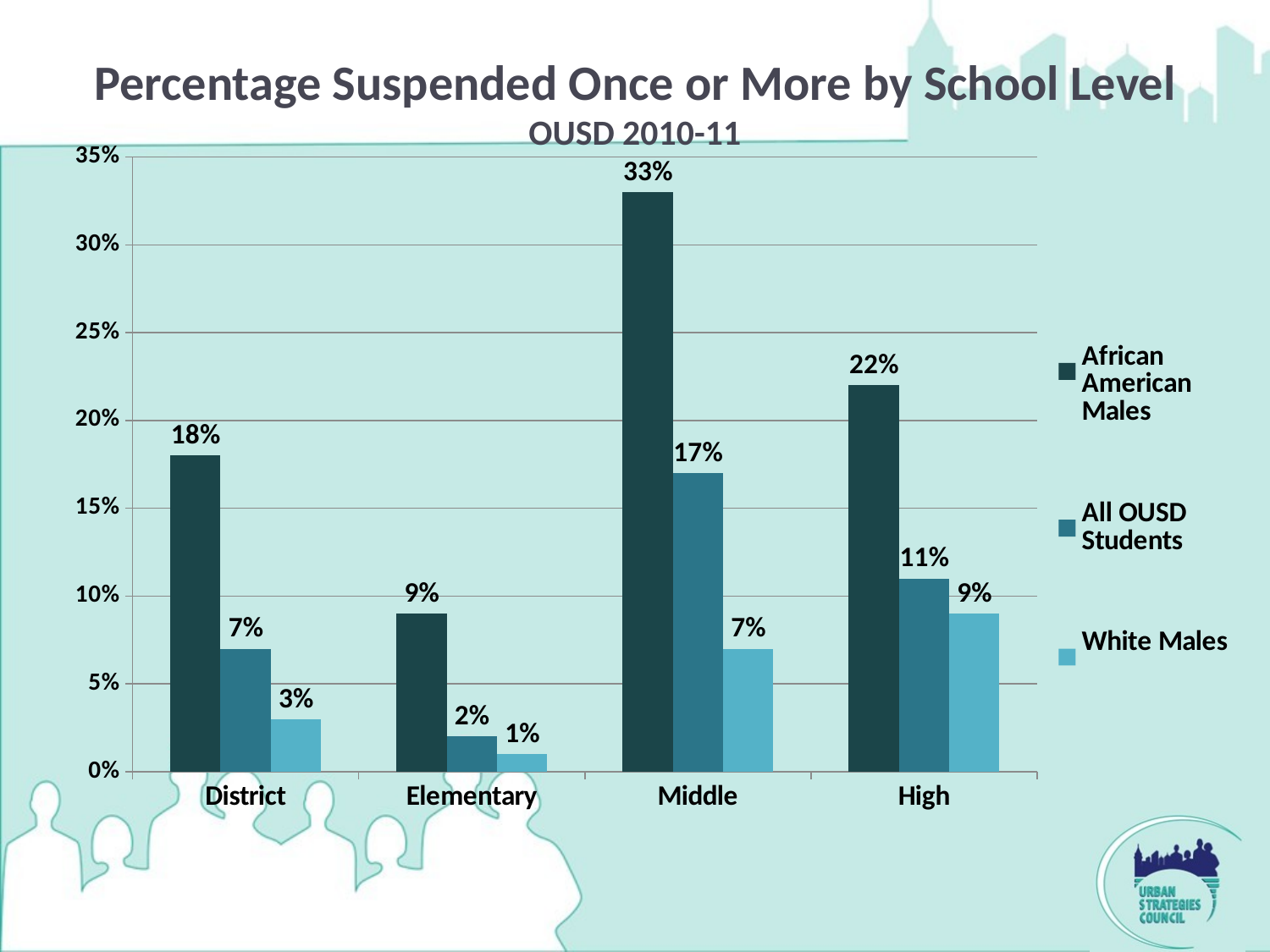
Which category has the lowest value for White Males? Elementary What is the value for All OUSD Students at the High school level? 11% Which school level has the highest value for African American Males? Middle How many categories are shown on the x axis? 4 Is the value for African American Males at the High school level greater or less than 20%? greater What kind of chart is shown on the slide? Bar chart What is the difference between African American Males and All OUSD Students at the District level? 11% What percentage of African American Males were suspended once or more at the Middle school level? 33% What is the value for White Males at the Elementary level? 1% Which is larger at the High school level: All OUSD Students or White Males? All OUSD Students What is the subtitle shown below the chart title? OUSD 2010-11 How many series does the legend list? 3